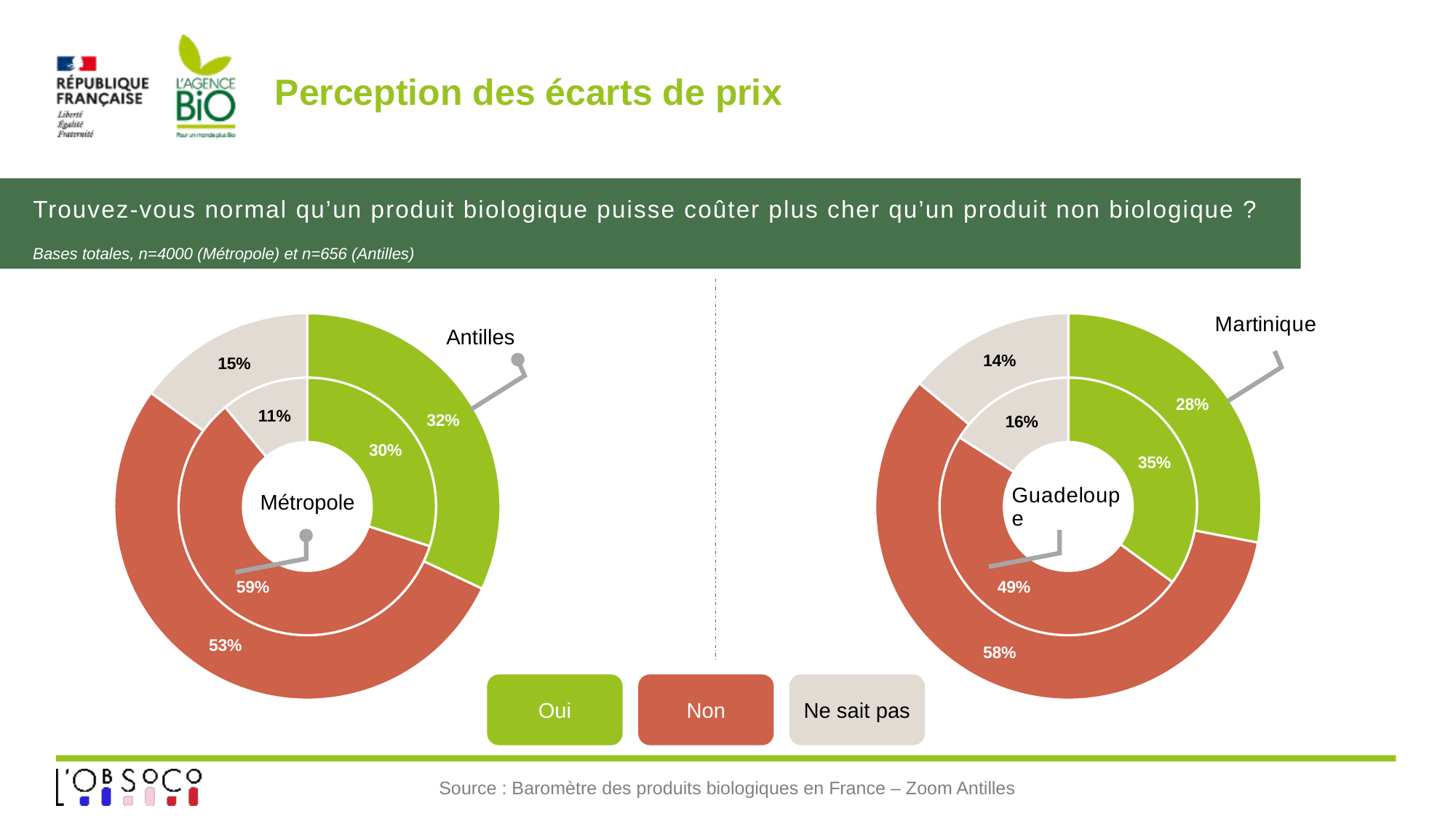
In the right chart, what is the difference between the "Oui" shares of Guadeloupe and Martinique? 7 percentage points In the left chart, what share of Métropole respondents answered "Non"? 59% In the right chart, what share of Guadeloupe respondents answered "Ne sait pas"? 16% How many answer categories does the legend list? 3 In the left chart, which answer has the largest share for Antilles? Non In the right chart, which answer has the smallest share for Martinique? Ne sait pas Which colour represents the "Oui" answer in the charts? Green In the right chart, what share of Martinique respondents answered "Non"? 58% In the left chart, what share of Antilles respondents answered "Oui"? 32% In the right chart, which is larger: the "Non" share for Martinique or for Guadeloupe? Martinique What type of chart is used on the slide? Doughnut chart In the left chart, which is larger: the "Ne sait pas" share for Antilles or for Métropole? Antilles